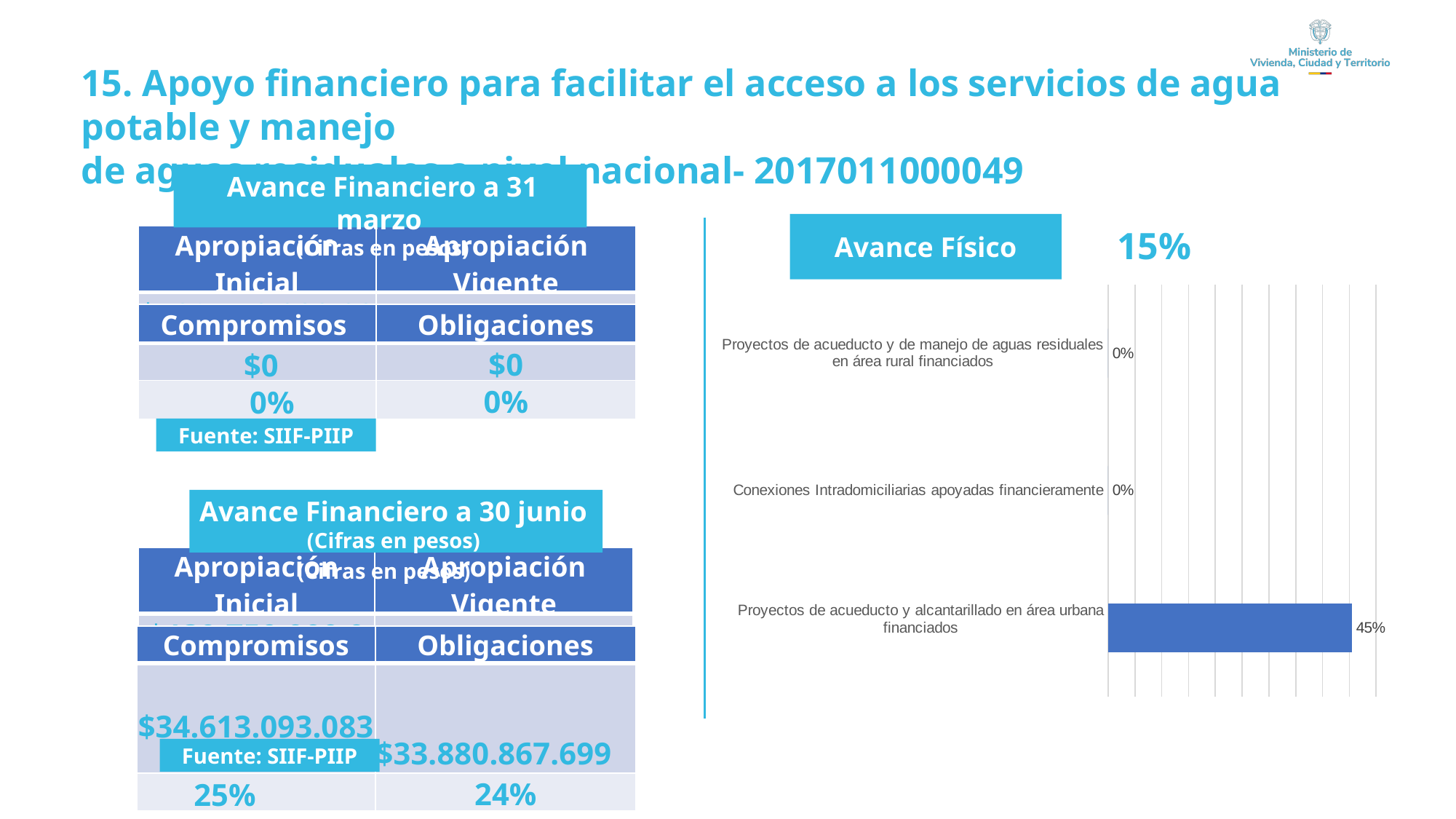
How many categories in the "Avance Físico" chart have a value of 0%? 2 In the "Avance Físico" chart, which is larger: the value for "Proyectos de acueducto y alcantarillado en área urbana financiados" or the value for "Proyectos de acueducto y de manejo de aguas residuales en área rural financiados"? Proyectos de acueducto y alcantarillado en área urbana financiados In the "Avance Físico" chart, what is the difference between the value for "Proyectos de acueducto y alcantarillado en área urbana financiados" and the value for "Conexiones Intradomiciliarias apoyadas financieramente"? 45% What colour is the bar in the "Avance Físico" chart? blue In the "Avance Físico" chart, what is the value for "Proyectos de acueducto y de manejo de aguas residuales en área rural financiados"? 0% How many categories does the "Avance Físico" bar chart show? 3 Which category has the highest value in the "Avance Físico" chart? Proyectos de acueducto y alcantarillado en área urbana financiados In the "Avance Físico" chart, what is the value for "Conexiones Intradomiciliarias apoyadas financieramente"? 0% What kind of chart is shown under the "Avance Físico" heading? bar chart In the "Avance Físico" chart, what is the value for "Proyectos de acueducto y alcantarillado en área urbana financiados"? 45% What overall percentage is displayed next to the "Avance Físico" heading? 15%